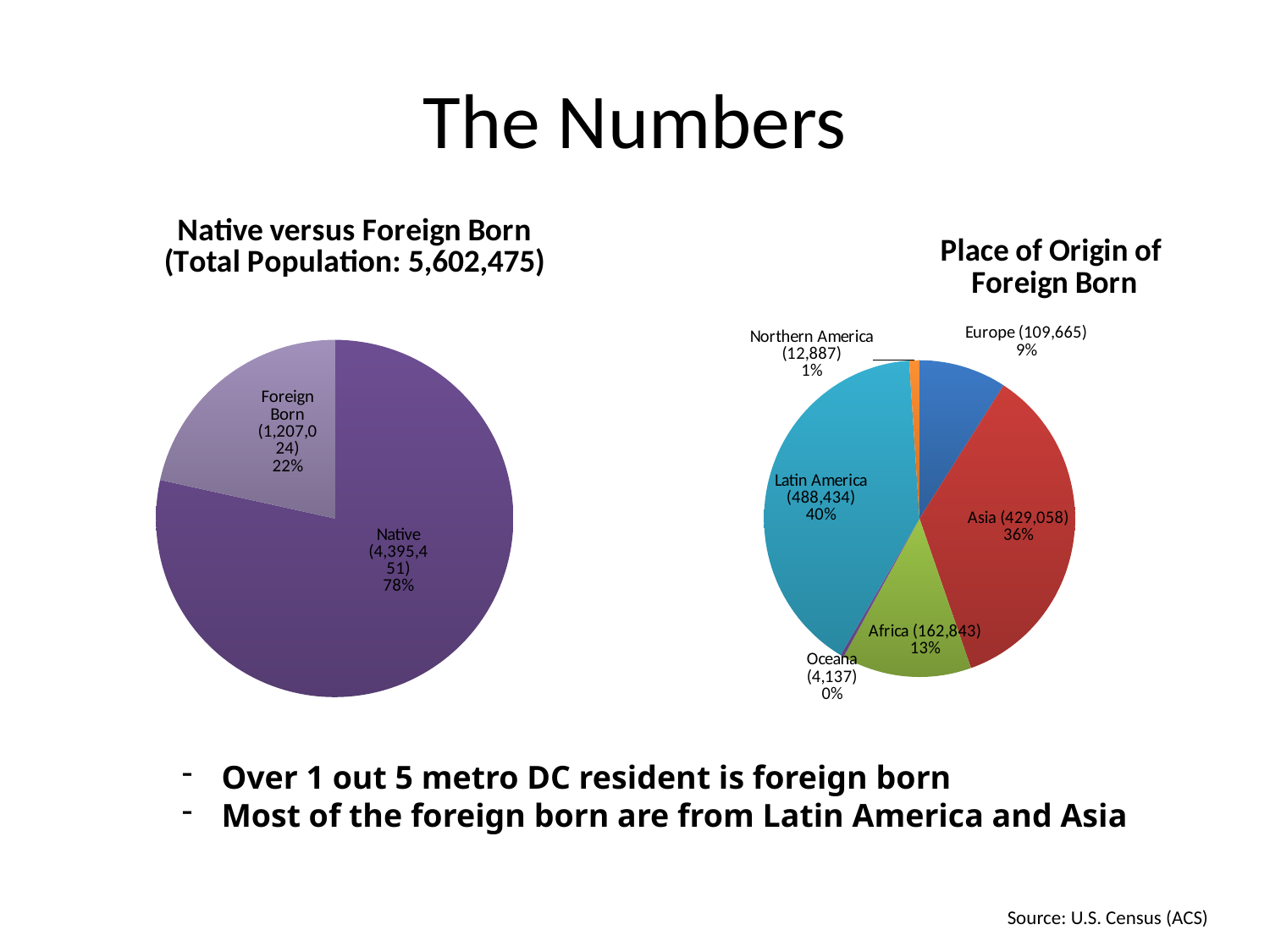
In the "Place of Origin of Foreign Born" chart, what is the value for Asia? 429,058 In the "Native versus Foreign Born" chart, what is the number of Foreign Born residents? 1,207,024 In the "Place of Origin of Foreign Born" chart, which is larger, Europe or Africa? Africa In the "Place of Origin of Foreign Born" chart, what percentage share does Africa have? 13% In the "Place of Origin of Foreign Born" chart, which region has the largest share? Latin America In the "Place of Origin of Foreign Born" chart, how many slices (regions) are shown? 6 In the "Place of Origin of Foreign Born" chart, which region has the smallest share? Oceana What type of chart is the "Native versus Foreign Born" chart on the left? Pie chart In the "Place of Origin of Foreign Born" chart, what is the difference between the Latin America and Asia values? 59,376 In the "Native versus Foreign Born" chart, what is the number of Native residents? 4,395,451 In the "Native versus Foreign Born" chart, what total population is stated in the title? 5,602,475 In the "Native versus Foreign Born" chart, what share of the population is Foreign Born? 22%